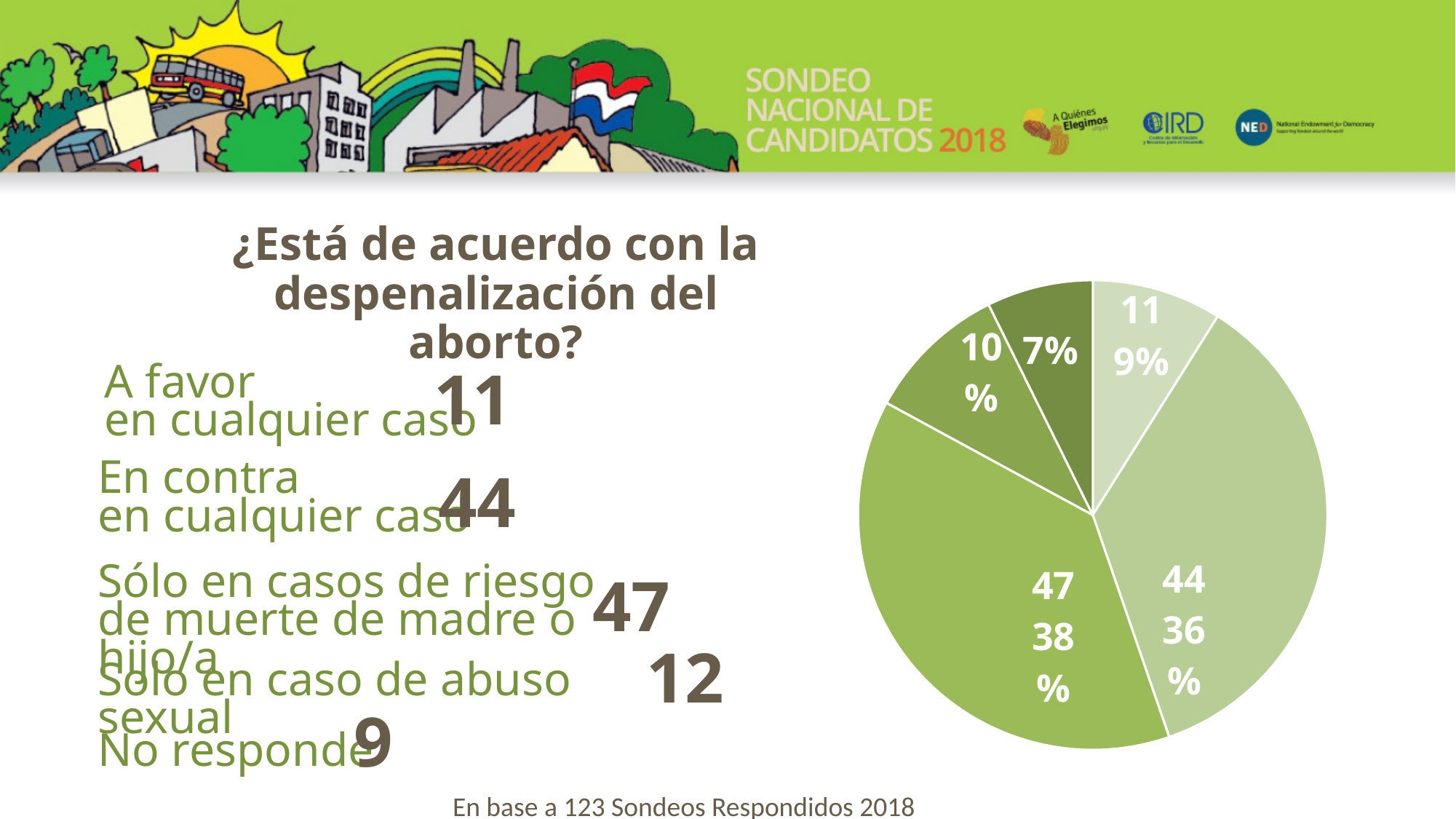
Which response category has the smallest slice of the pie? No responde Which has more respondents, 'A favor en cualquier caso' or 'Sólo en caso de abuso sexual'? Sólo en caso de abuso sexual What is the difference between the number of respondents for 'Sólo en casos de riesgo de muerte de madre o hijo/a' and 'En contra en cualquier caso'? 3 How many respondents answered 'Sólo en caso de abuso sexual'? 12 Which response category has the largest slice of the pie? Sólo en casos de riesgo de muerte de madre o hijo/a How many slices does the pie chart have? 5 What percentage share does the pie chart show for 'En contra en cualquier caso'? 36% What percentage share does the pie chart show for 'Sólo en casos de riesgo de muerte de madre o hijo/a'? 38% What percentage share does the pie chart show for 'A favor en cualquier caso'? 9% How many respondents answered 'En contra en cualquier caso'? 44 What kind of chart is shown on the slide? pie chart